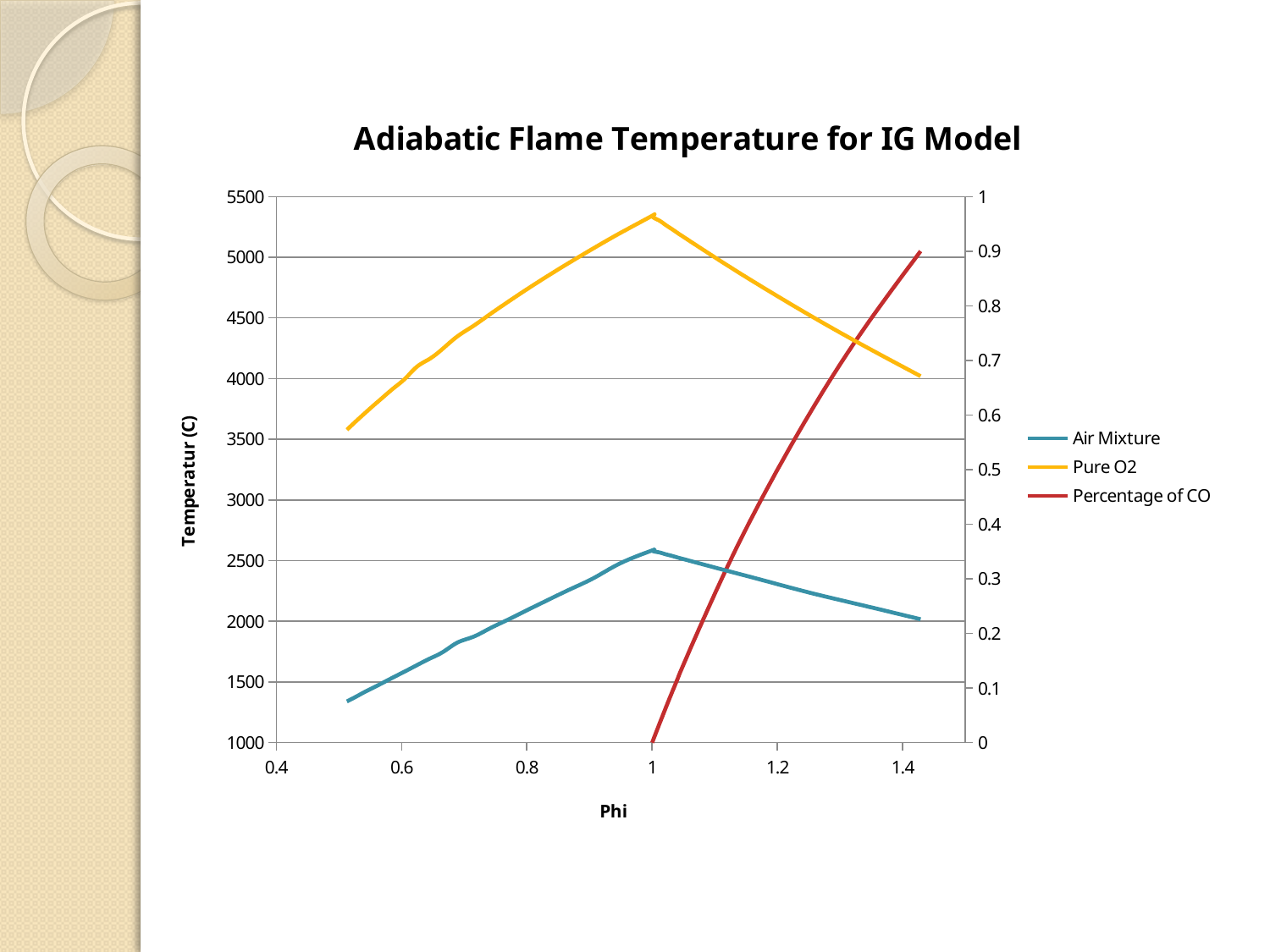
What is the title of the chart? Adiabatic Flame Temperature for IG Model At Phi = 1, which series has the higher temperature, Pure O2 or Air Mixture? Pure O2 Is the Air Mixture value at Phi = 1 greater or less than 3000? less What kind of chart is shown on the slide? Line chart At what value of Phi does the Pure O2 line reach its peak? 1 Is the Air Mixture value at Phi = 0.6 greater or less than 2000? less Is the Pure O2 value at Phi = 1.4 greater or less than 4500? less Does the Percentage of CO line rise or fall as Phi increases from 1 to 1.4? Rise How many series does the legend list? 3 What is the label of the x axis? Phi